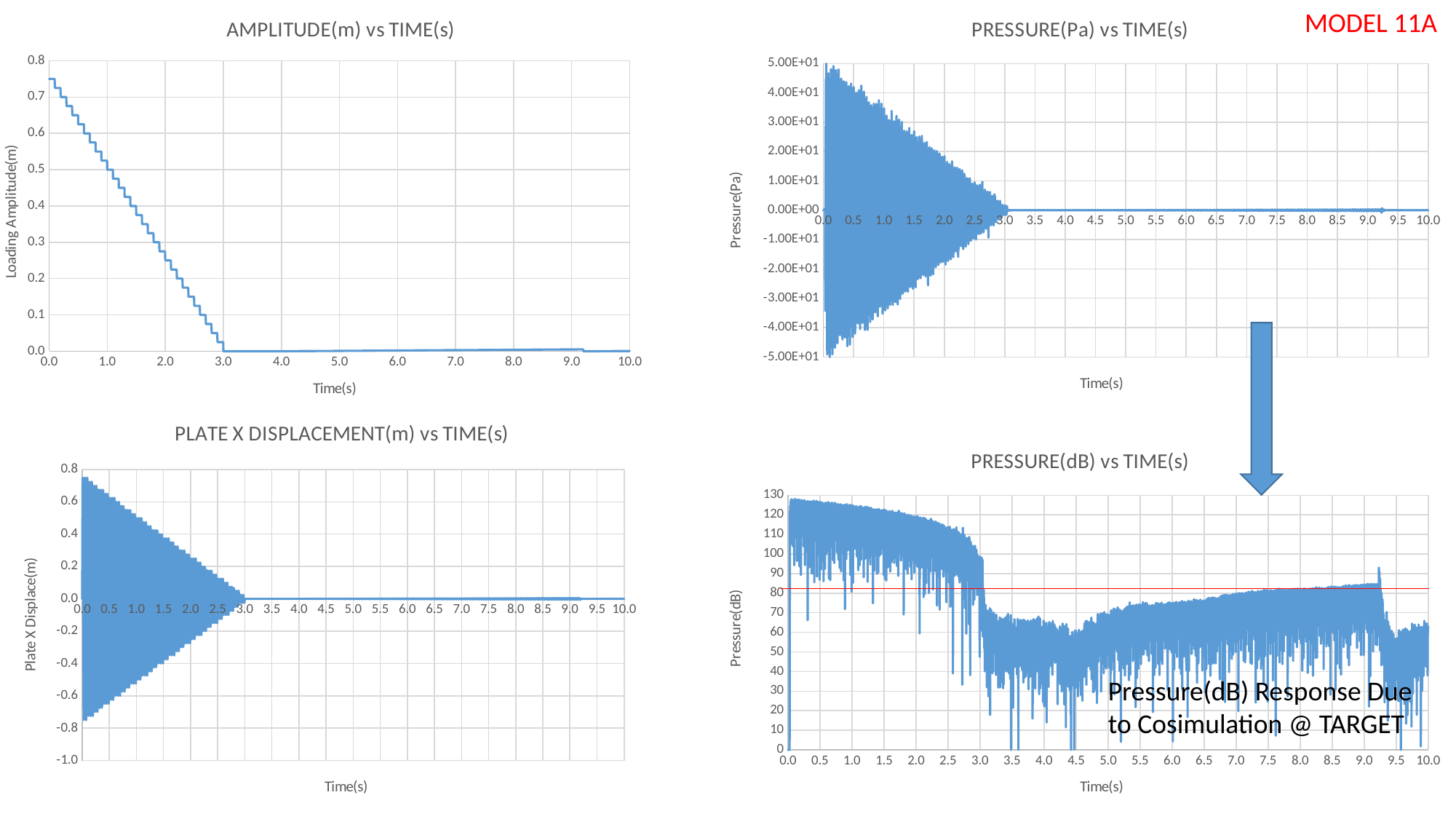
In the AMPLITUDE(m) vs TIME(s) chart, is the value at 1.0 s greater or less than 0.4? greater In the PRESSURE(Pa) vs TIME(s) chart, is the pressure at 5.0 s greater or less than 1.00E+01? less What kind of chart is the AMPLITUDE(m) vs TIME(s) chart? line chart What is the label on the vertical axis of the PLATE X DISPLACEMENT(m) vs TIME(s) chart? Plate X Displace(m) In the AMPLITUDE(m) vs TIME(s) chart, does the loading amplitude rise or fall between 0.0 s and 3.0 s? fall In the AMPLITUDE(m) vs TIME(s) chart, is the value at 2.0 s greater or less than 0.4? less In the AMPLITUDE(m) vs TIME(s) chart, what value does the loading amplitude settle at after 3.0 s? 0.0 In the PRESSURE(Pa) vs TIME(s) chart, what is the highest value shown on the vertical axis? 5.00E+01 In the PLATE X DISPLACEMENT(m) vs TIME(s) chart, does the size of the oscillation increase or decrease between 0.0 s and 3.0 s? decrease